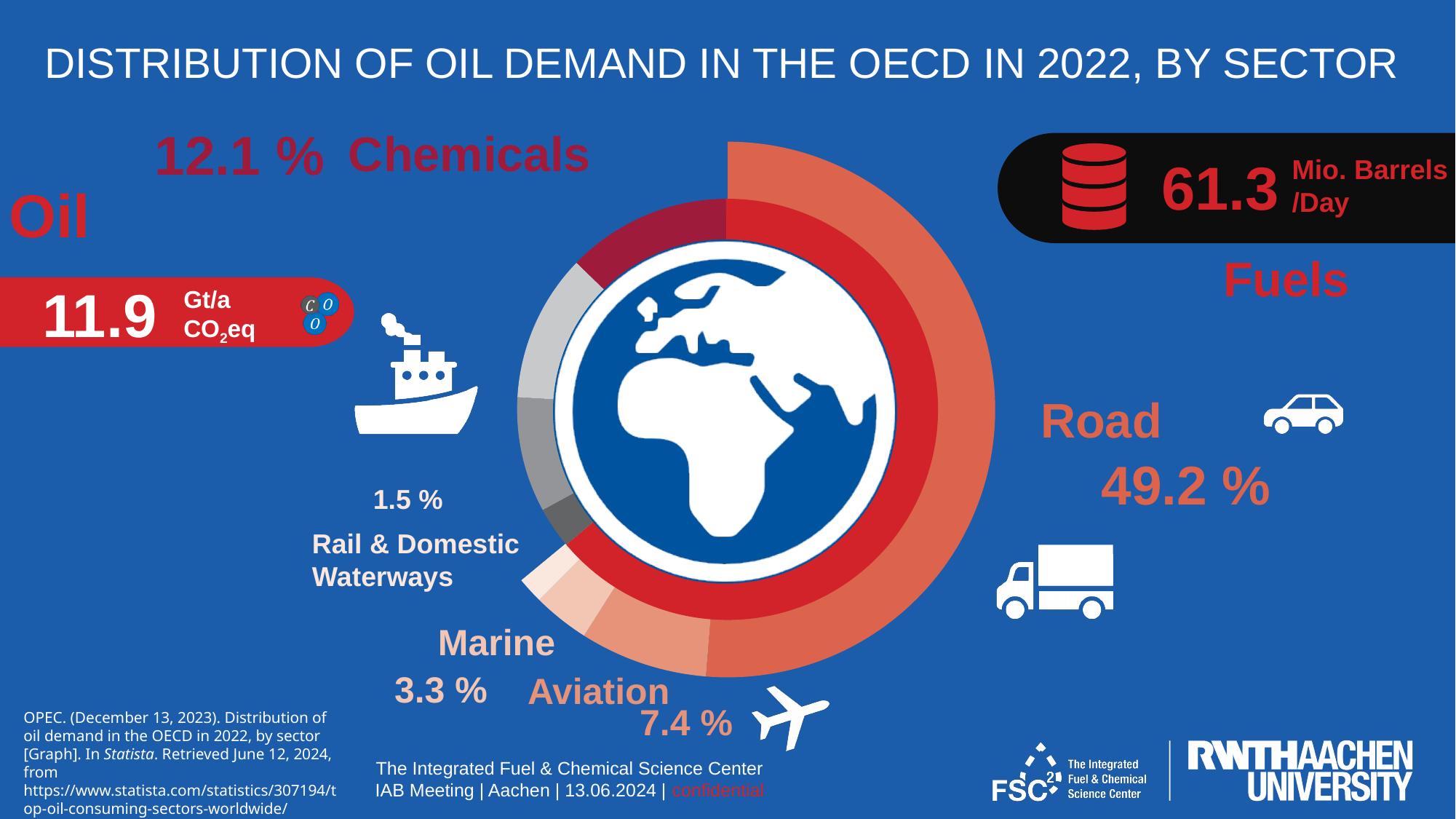
What percentage is shown for Chemicals? 12.1 % Which labelled sector has the smallest share of oil demand? Rail & Domestic Waterways What kind of chart is used to show the distribution of oil demand? Donut (pie) chart Which has a larger share, Chemicals or Aviation? Chemicals What share of OECD oil demand in 2022 does the Road sector account for? 49.2 % Which labelled sector has the largest share of oil demand? Road What is the difference in percentage points between the Road share and the Chemicals share? 37.1 % What is the title of the slide? Distribution of oil demand in the OECD in 2022, by sector What percentage is shown for Rail & Domestic Waterways? 1.5 % What is the difference between the Aviation share and the Marine share? 4.1 % What percentage is shown for Marine? 3.3 % What percentage is shown for Aviation? 7.4 %